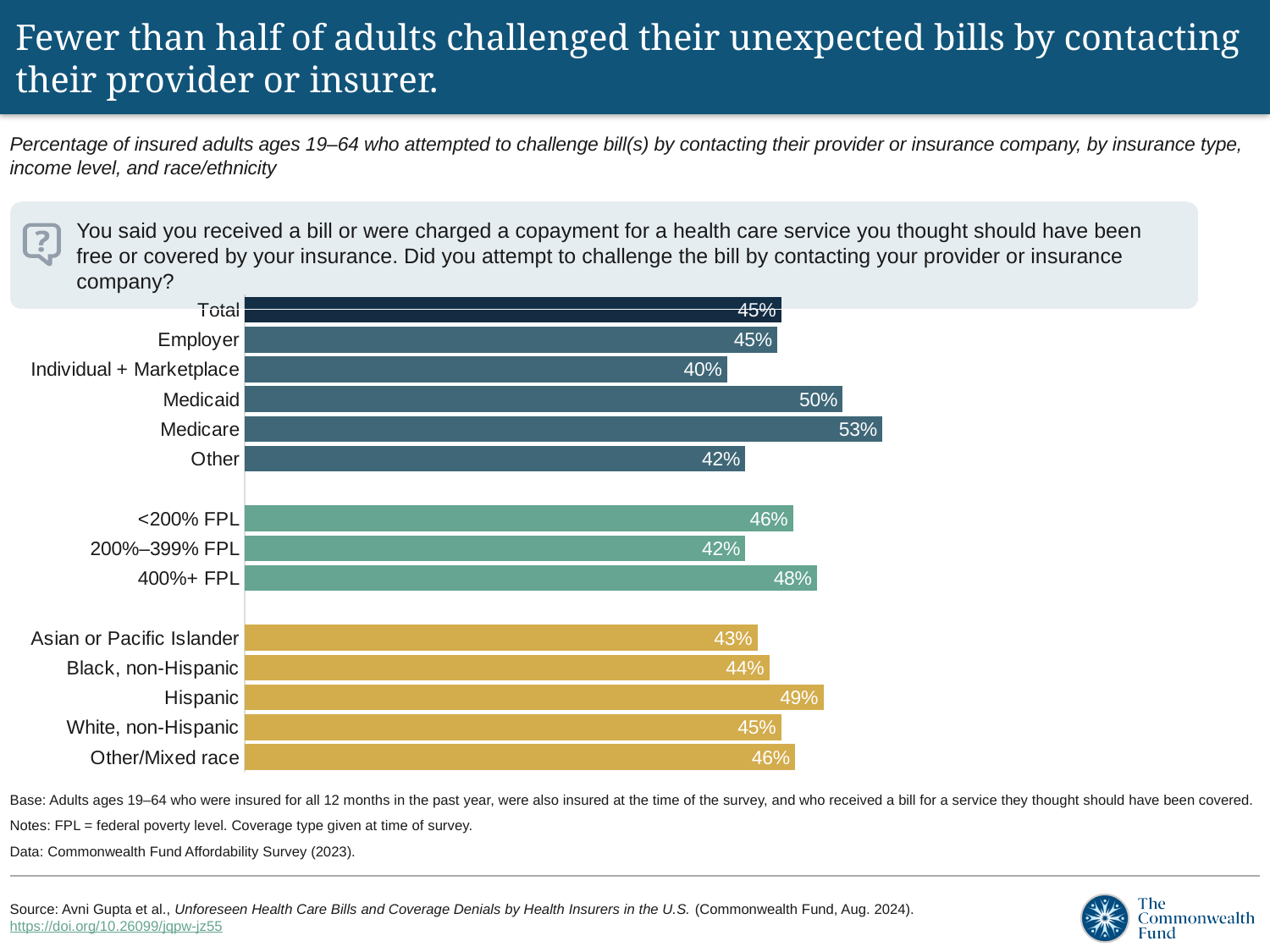
Which category has the highest value on the chart? Medicare What is the difference between the values for 400%+ FPL and 200%–399% FPL? 6 percentage points What percentage is shown for Medicare? 53% What percentage is shown for Hispanic adults? 49% What kind of chart is shown on the slide? Bar chart What is the difference between the values for Medicare and Individual + Marketplace? 13 percentage points Which is larger, the value for Hispanic or the value for Black, non-Hispanic? Hispanic Which category has the lowest value on the chart? Individual + Marketplace Which is larger, the value for Medicaid or the value for Employer? Medicaid What is the value for Individual + Marketplace? 40% How many categories (bars) are plotted on the chart? 14 What is the value for the 200%–399% FPL group? 42%